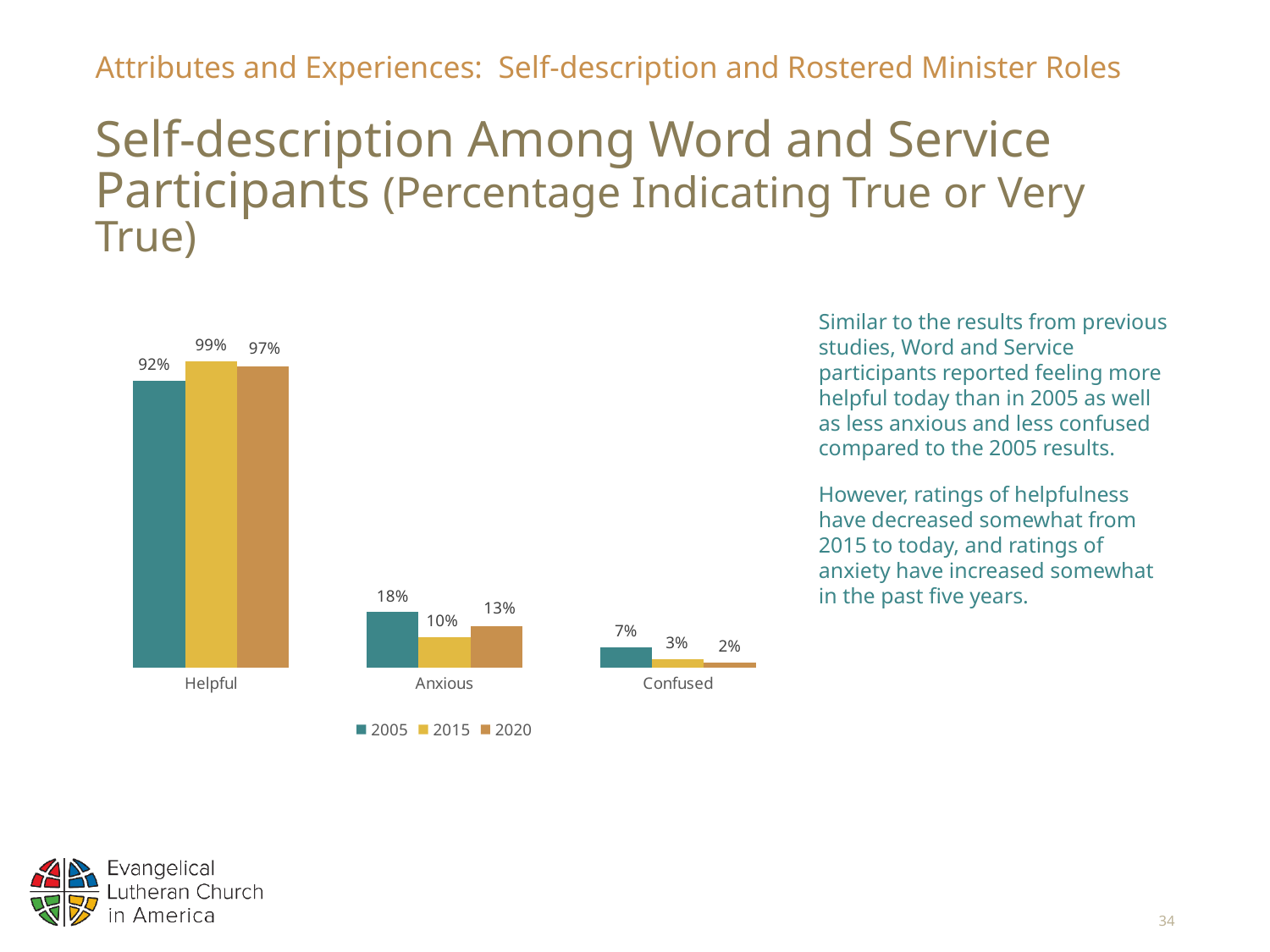
What kind of chart is shown on the slide? Bar chart What is the value for Anxious in 2015? 10% Which category has the lowest value in 2005? Confused In which year was the Helpful rating highest? 2015 Which years are listed in the legend? 2005, 2015, 2020 How many series does the legend list? 3 What is the value for Confused in 2020? 2% By how many percentage points did the Helpful rating change from 2005 to 2020? 5% How many categories are shown on the x axis? 3 What percentage of Word and Service participants described themselves as Helpful in 2005? 92% What is the difference between the Anxious values for 2005 and 2015? 8% Which is larger, the Anxious value for 2020 or the Anxious value for 2015? 2020